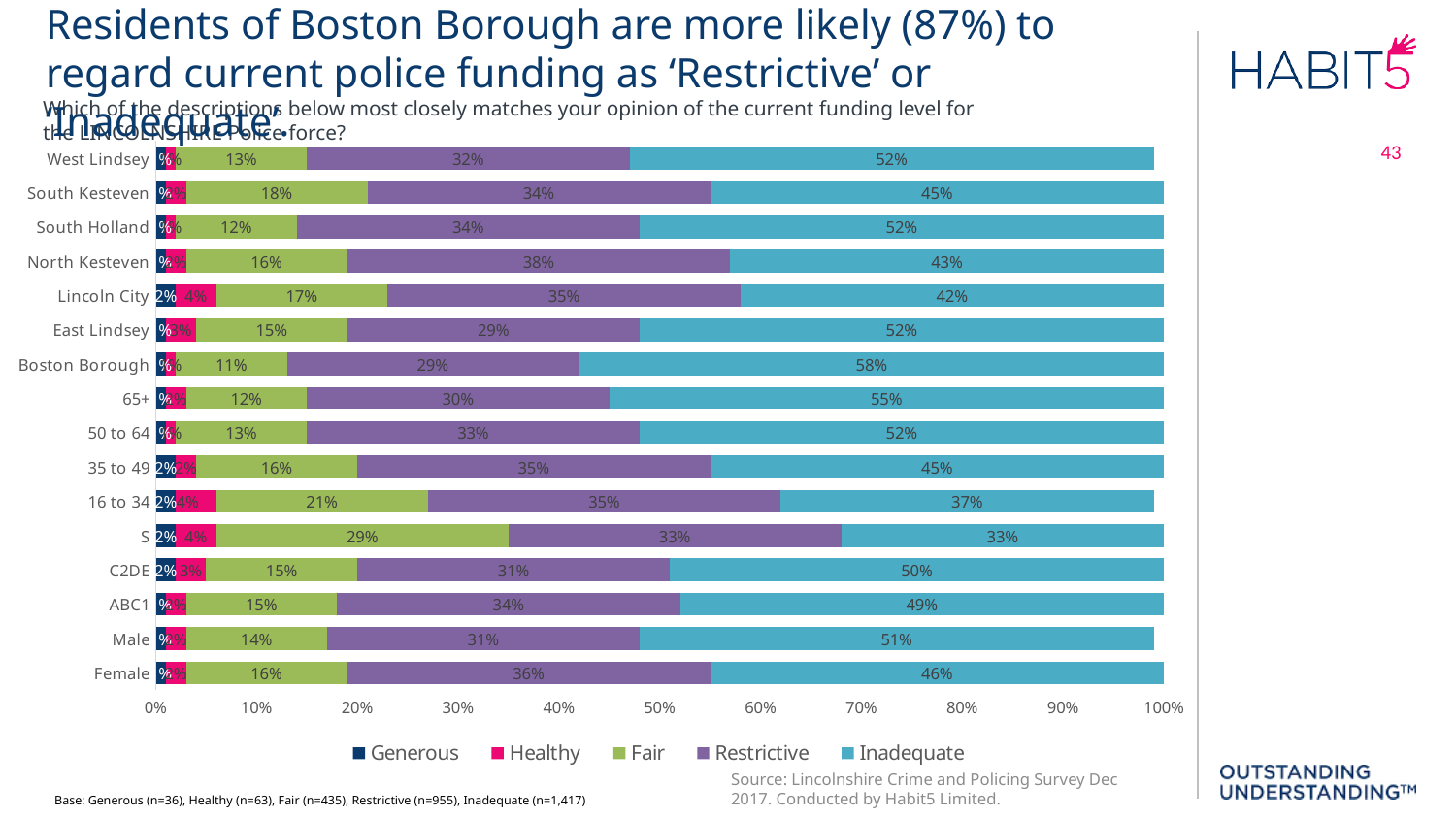
What is the difference between the 'Inadequate' values for Boston Borough and West Lindsey? 6 percentage points What is the combined 'Restrictive' and 'Inadequate' share for Boston Borough? 87% Which category has the highest 'Inadequate' value? Boston Borough What kind of chart is shown on the slide? Stacked bar chart Which category has the lowest 'Inadequate' value? S Which has the larger 'Restrictive' value, Male or Female? Female What is the 'Restrictive' value for North Kesteven? 38% What is the 'Inadequate' value for Boston Borough? 58% How many categories (bars) are plotted on the chart? 16 What is the 'Fair' value for the 16 to 34 category? 21% Which colour represents 'Fair' in the legend? Green How many series does the legend list? 5